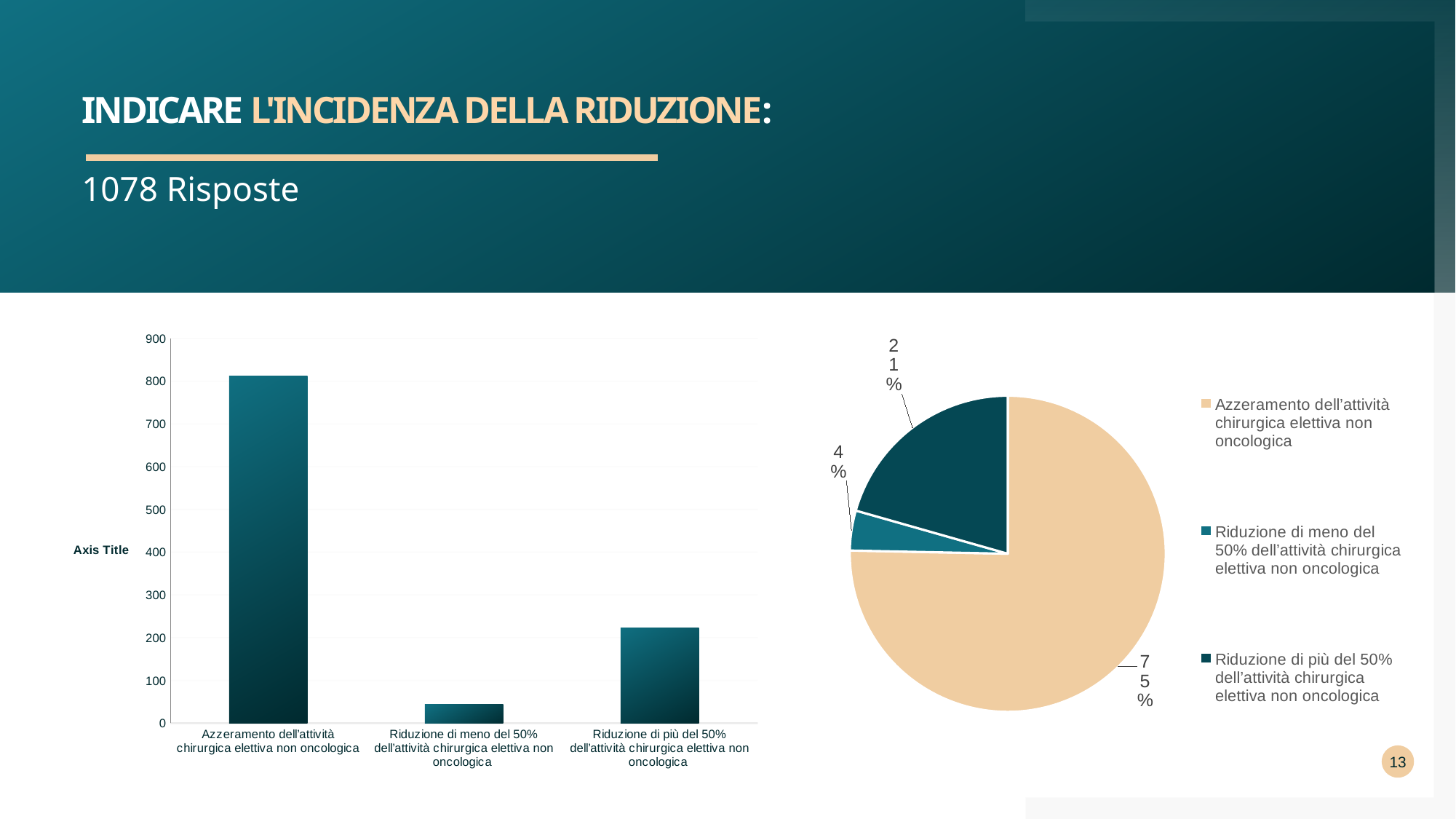
In the bar chart on the left, is the value for Riduzione di più del 50% dell'attività chirurgica elettiva non oncologica greater or less than 300? less In the pie chart on the right, how many entries does the legend list? 3 In the bar chart on the left, is the value for Riduzione di meno del 50% dell'attività chirurgica elettiva non oncologica greater or less than 100? less In the bar chart on the left, which is larger: the bar for Riduzione di più del 50% or the bar for Riduzione di meno del 50%? Riduzione di più del 50% dell'attività chirurgica elettiva non oncologica What kind of chart is the chart on the left of the slide? bar chart What kind of chart is the chart on the right of the slide? pie chart In the pie chart on the right, what share does Riduzione di più del 50% dell'attività chirurgica elettiva non oncologica have? 21% In the bar chart on the left, is the value for Azzeramento dell'attività chirurgica elettiva non oncologica greater or less than 700? greater In the bar chart on the left, which category has the highest bar? Azzeramento dell'attività chirurgica elettiva non oncologica In the pie chart on the right, what share does Azzeramento dell'attività chirurgica elettiva non oncologica have? 75% In the bar chart on the left, how many categories are shown on the x axis? 3 In the bar chart on the left, which category has the lowest bar? Riduzione di meno del 50% dell'attività chirurgica elettiva non oncologica